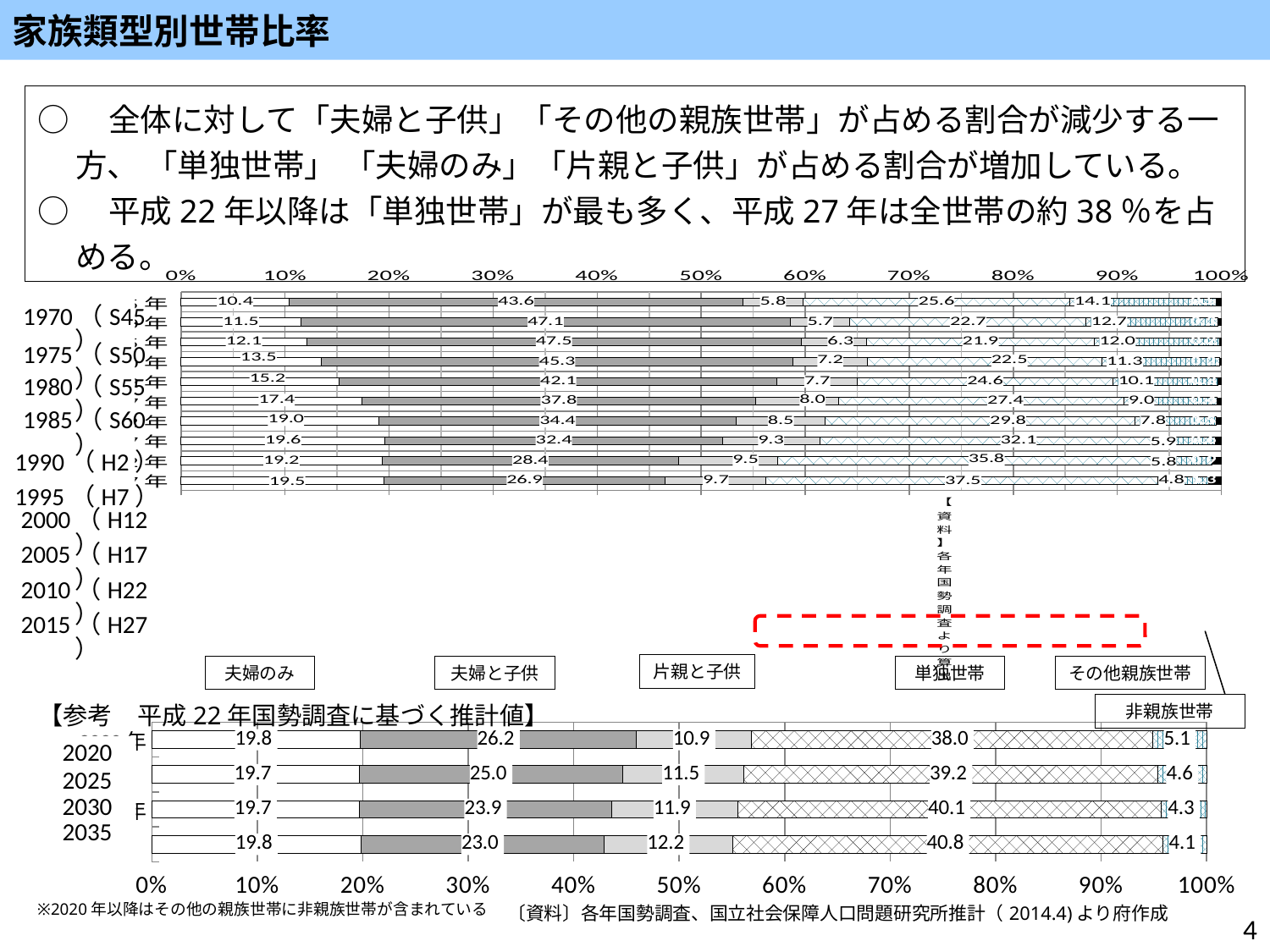
In the top chart (1970–2015), what is the value for 単独世帯 in 2015? 37.5 What kind of chart is the bottom chart (2020–2035 projections)? stacked bar chart In the top chart (1970–2015), does the value for 夫婦と子供 rise or fall from 1980 to 2015? fall In the bottom chart (2020–2035 projections), how many years are plotted? 4 In the top chart (1970–2015), which year has the highest value for 夫婦と子供? 1980 In the top chart (1970–2015), what is the value for 片親と子供 in 1990? 7.7 In the top chart (1970–2015), which year has the lowest value for その他親族世帯? 2015 In the bottom chart (2020–2035 projections), which is larger in 2030: 夫婦と子供 or 片親と子供? 夫婦と子供 In the top chart (1970–2015), what is the difference between the 単独世帯 values for 2015 and 1970? 11.9 In the bottom chart (2020–2035 projections), what is the value for 単独世帯 in 2035? 40.8 In the top chart (1970–2015), what is the value for 夫婦と子供 in 1970? 43.6 In the bottom chart (2020–2035 projections), what is the value for 夫婦と子供 in 2020? 26.2